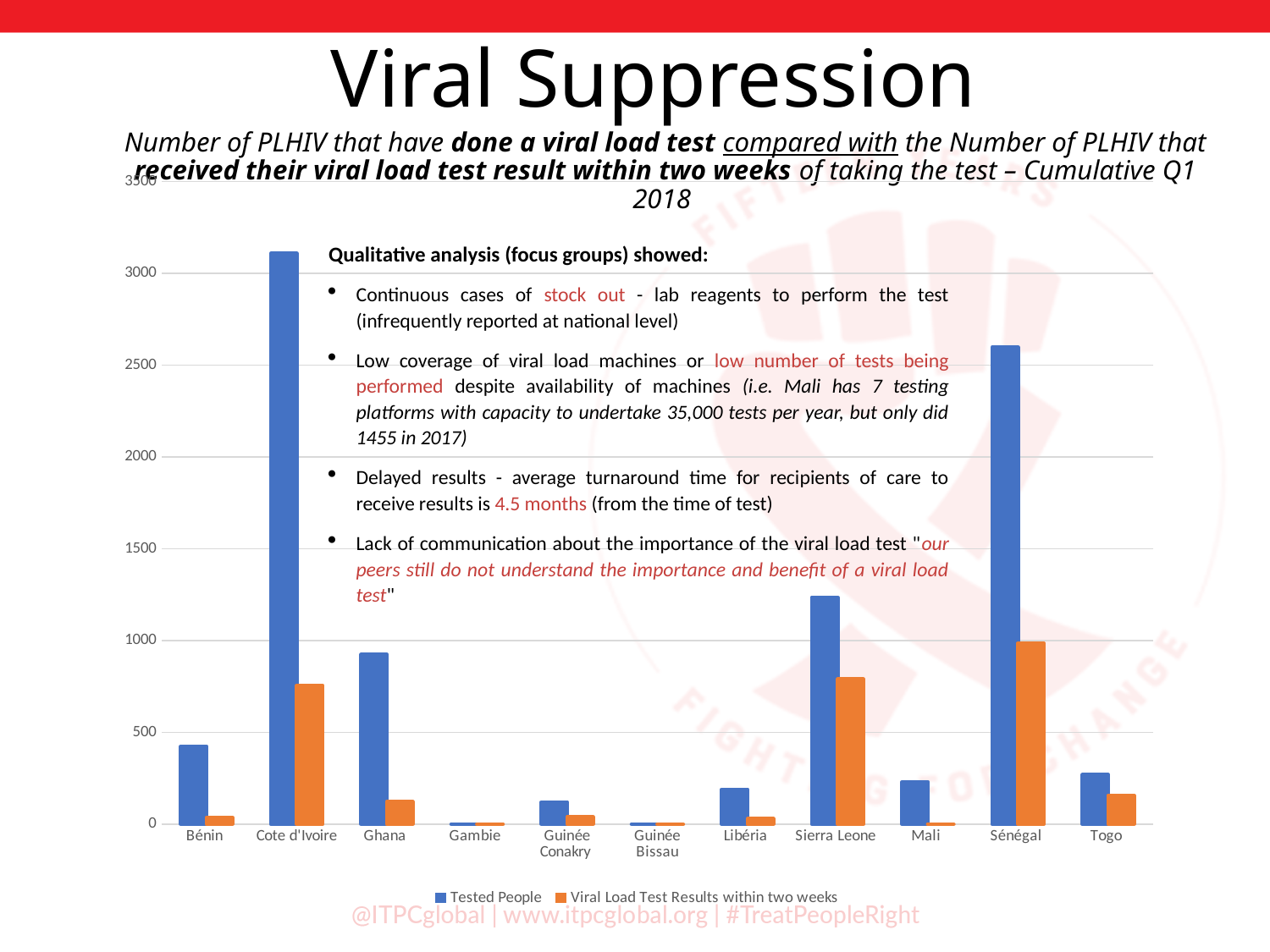
How many countries are shown on the x axis of the chart? 11 Is the Viral Load Test Results within two weeks value for Sierra Leone greater or less than 1000? less Which colour represents the Tested People series in the chart? blue Which is larger: the Tested People value for Mali or the Tested People value for Bénin? Bénin Which is larger: the Tested People value for Sierra Leone or the Tested People value for Ghana? Sierra Leone Is the Tested People value for Ghana greater or less than 1000? less Which country has the highest value for Viral Load Test Results within two weeks? Sénégal Is the Tested People value for Sénégal greater or less than 2500? greater Which country has the highest value for Tested People? Cote d'Ivoire How many series does the chart's legend list? 2 What kind of chart is shown on the slide? bar chart